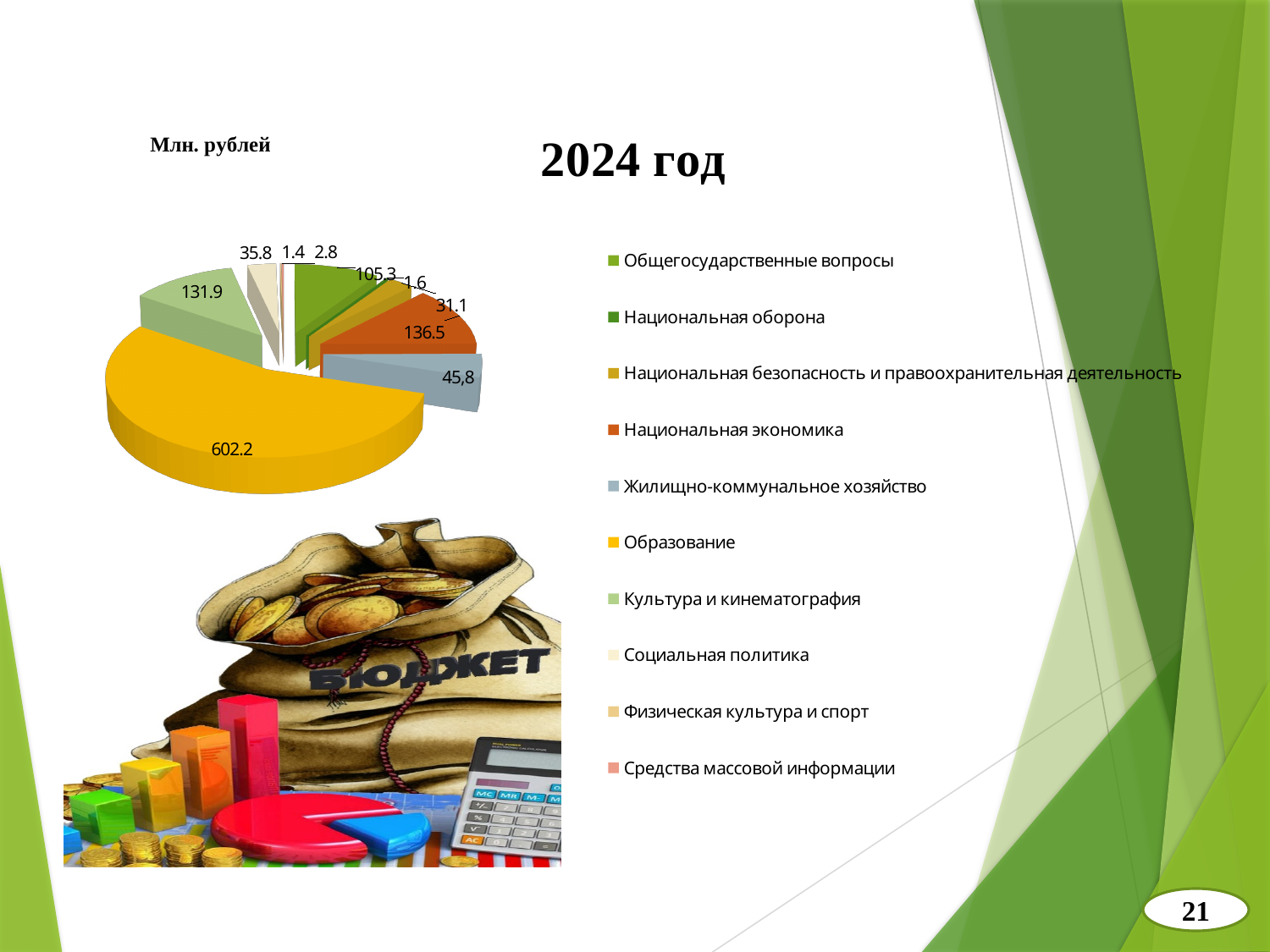
In what units are the values of the pie chart given, according to the label above the chart? Млн. рублей How many categories does the legend of the pie chart list? 10 What is the value of the largest slice in the pie chart? 602.2 What is the value for Образование in the pie chart? 602.2 What is the value of the smallest slice in the pie chart? 1.4 What is the value for Национальная экономика in the pie chart? 136.5 Which category has the largest slice in the pie chart? Образование What is the value for Культура и кинематография in the pie chart? 131.9 What is the value for Жилищно-коммунальное хозяйство in the pie chart? 45,8 What is the value for Общегосударственные вопросы in the pie chart? 105.3 What is the difference between the values for Образование (602.2) and Национальная экономика (136.5)? 465.7 What kind of chart is shown on the slide? Pie chart